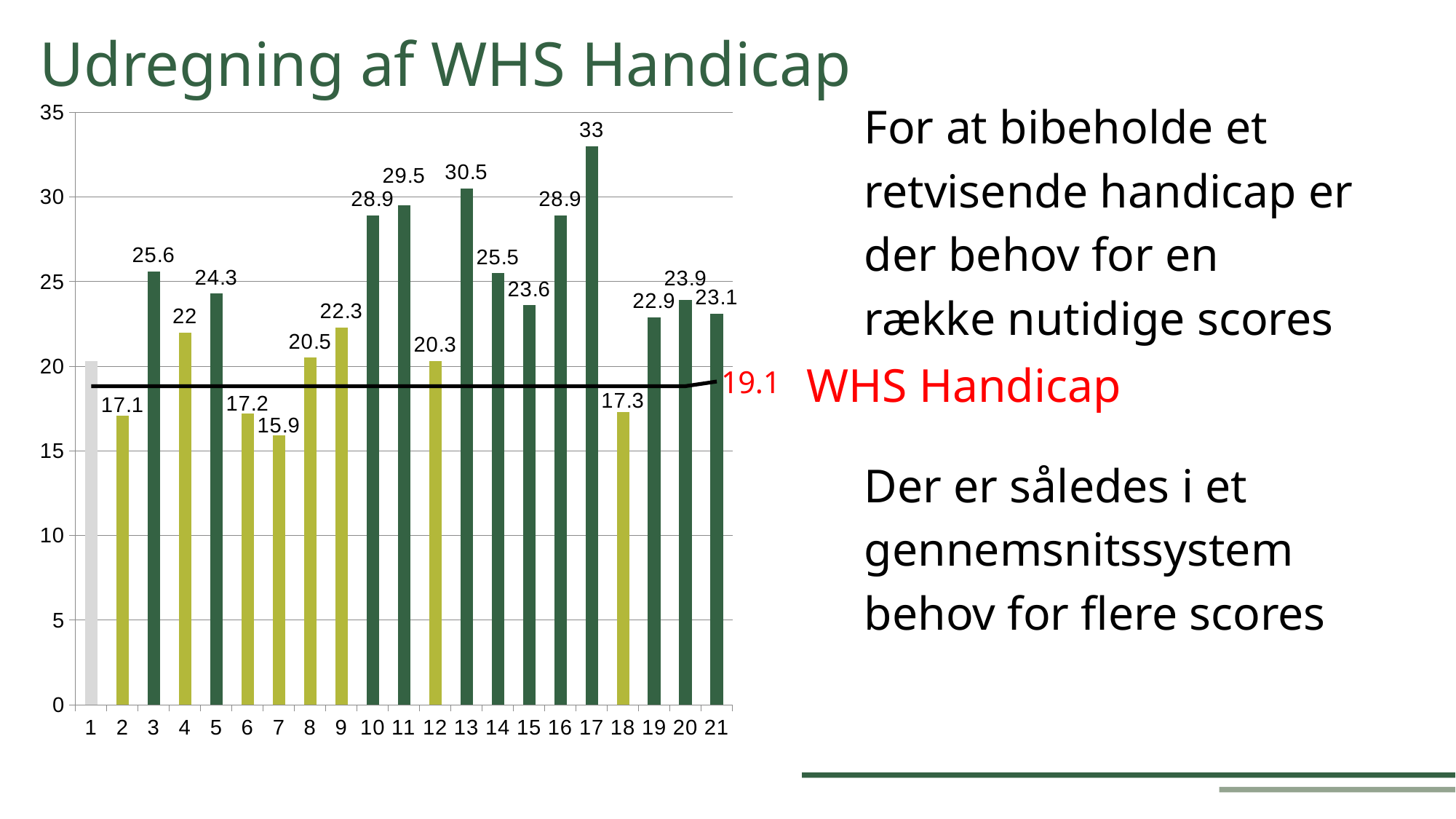
What is the difference between the values for category 13 and category 12? 10.2 Which category has the highest value? 17 What kind of chart is shown on the slide? combination bar and line chart What is the value for category 11? 29.5 Which is larger, the value for category 3 or the value for category 5? category 3 What is the value for category 17? 33 What is the value for category 7? 15.9 Which labelled category has the lowest value? 7 Is the value for category 1 greater or less than 25? less How many categories are shown on the x axis of the chart? 21 What is the difference between the values for category 4 and category 2? 4.9 What value is shown for the WHS Handicap line on the chart? 19.1